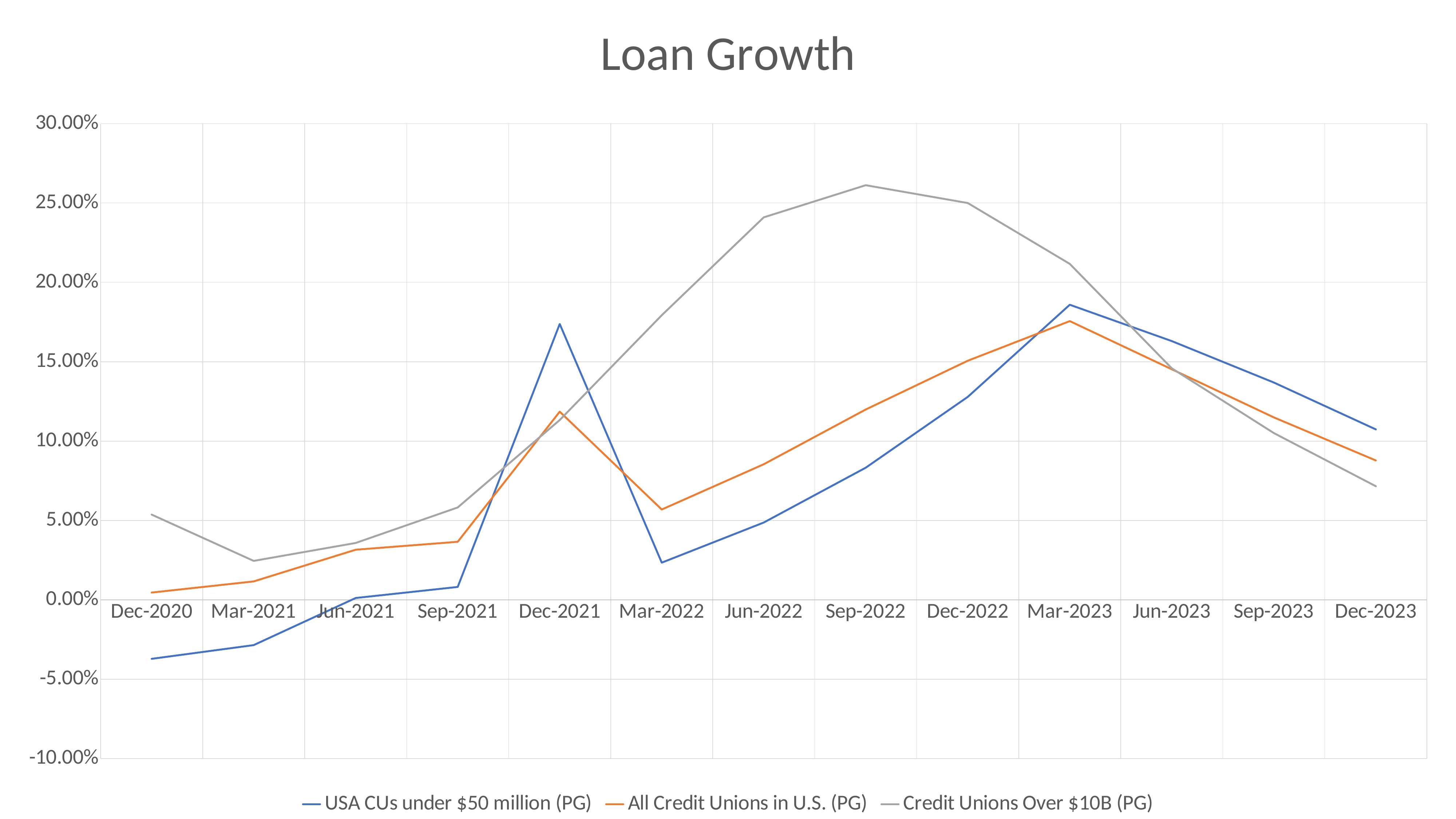
At Dec-2021, which series has the higher value: USA CUs under $50 million (PG) or All Credit Unions in U.S. (PG)? USA CUs under $50 million (PG) Does the Credit Unions Over $10B (PG) series rise or fall from Sep-2022 to Dec-2023? fall How many time points are shown on the x axis? 13 Is the value for All Credit Unions in U.S. (PG) at Mar-2023 greater or less than 15.00%? greater At Jun-2022, which series has the higher value: Credit Unions Over $10B (PG) or USA CUs under $50 million (PG)? Credit Unions Over $10B (PG) At which time point does the USA CUs under $50 million (PG) series reach its highest value? Mar-2023 What kind of chart is shown on the slide? line chart At which time point does the Credit Unions Over $10B (PG) series reach its highest value? Sep-2022 At which time point is the USA CUs under $50 million (PG) series at its lowest? Dec-2020 Is the value for USA CUs under $50 million (PG) at Dec-2020 greater or less than 0.00%? less Is the value for Credit Unions Over $10B (PG) at Sep-2022 greater or less than 25.00%? greater How many series does the legend list? 3